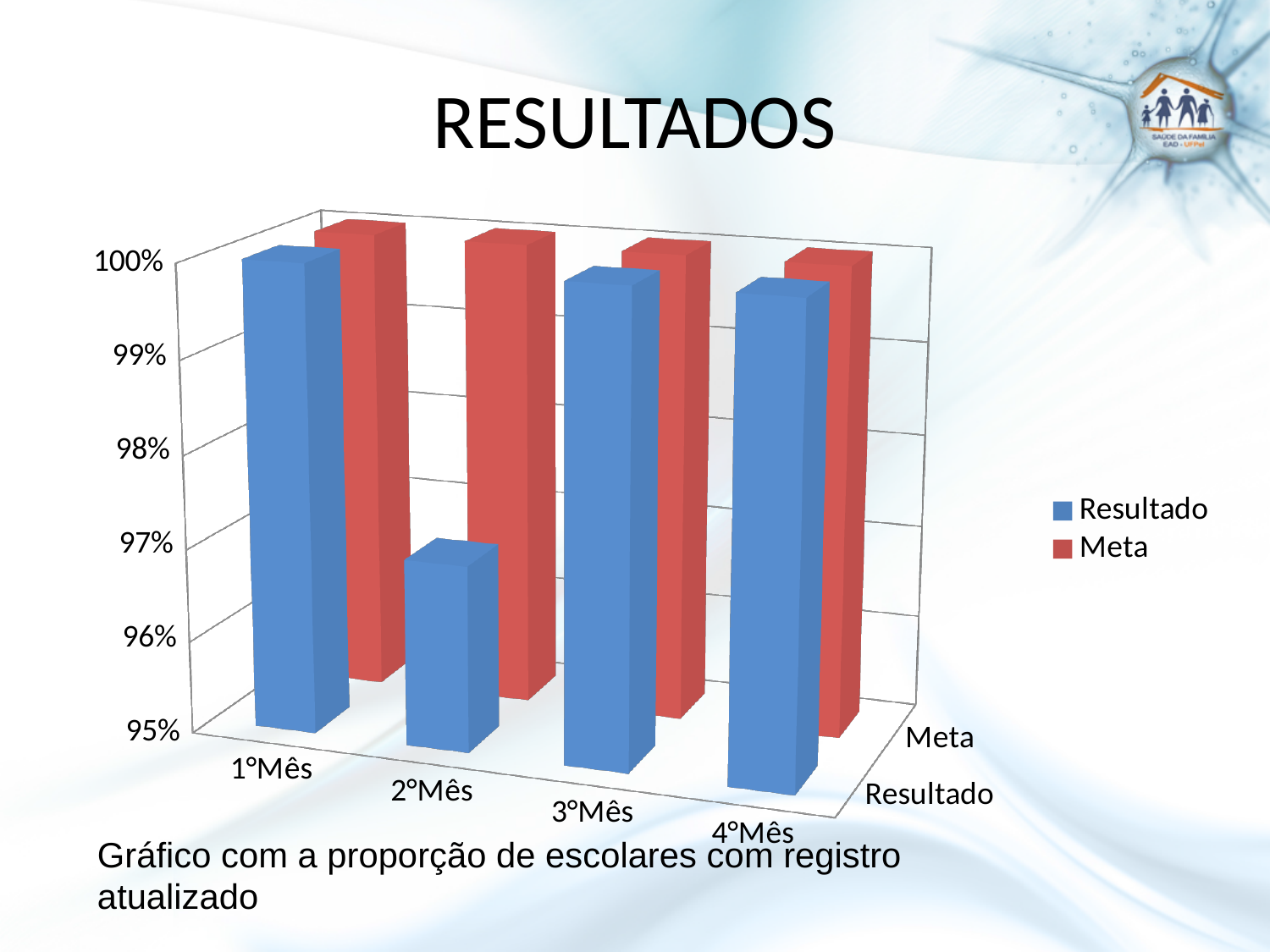
Which month has the lowest Resultado value? 2°Mês Is the Meta value for 3°Mês greater or less than 99%? greater What is the lowest value shown on the vertical axis? 95% What kind of chart is shown on the slide? bar chart Is the Resultado value for 1°Mês greater or less than 99%? greater Which is larger, the Resultado value for 1°Mês or for 2°Mês? 1°Mês How many series does the legend list? 2 How many month categories are shown on the x axis? 4 Which is larger for 2°Mês, the Resultado value or the Meta value? Meta What are the two series named in the legend? Resultado and Meta Is the Resultado value for 2°Mês greater or less than 98%? less What colour are the Meta bars? red